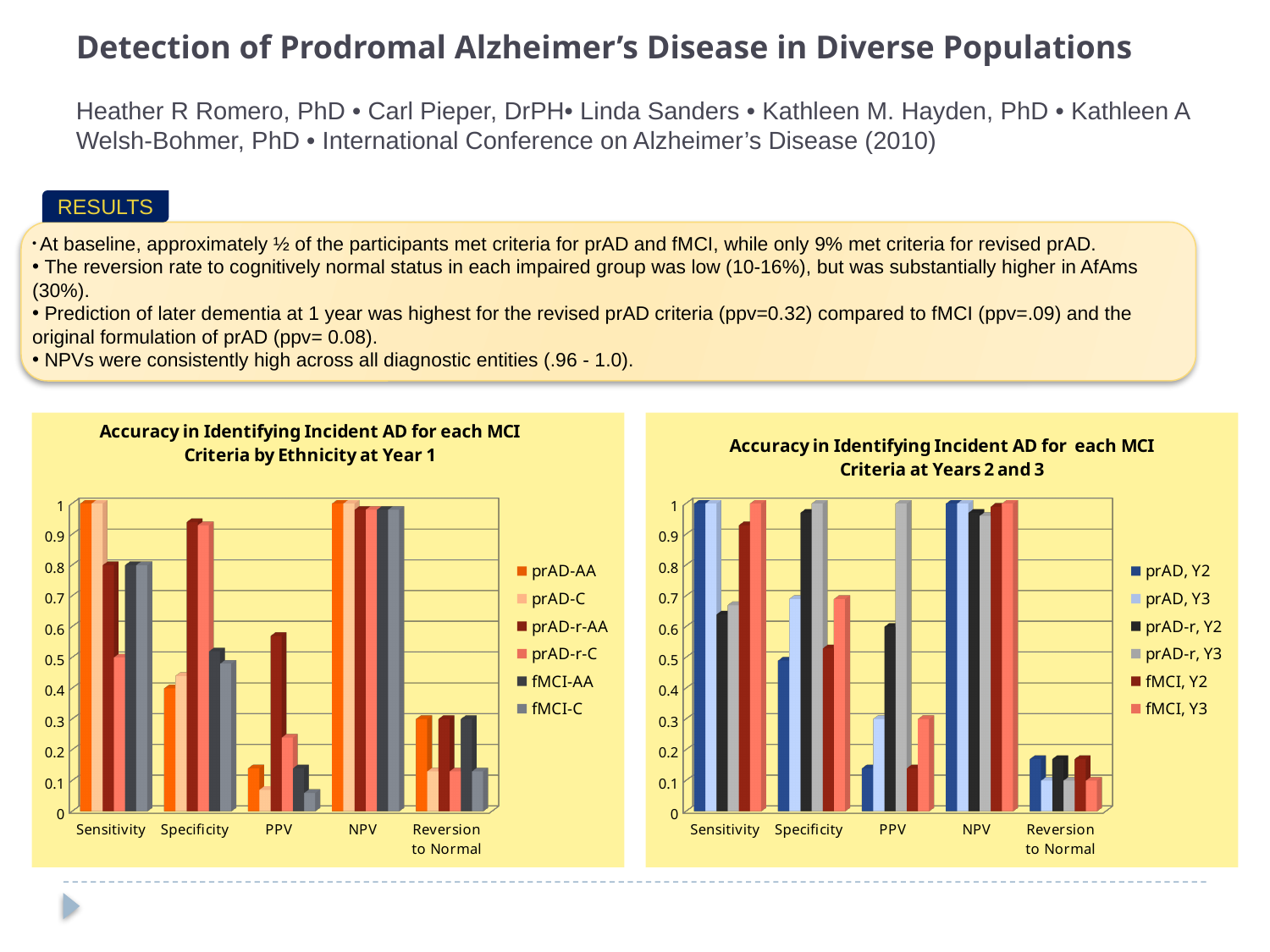
What kind of chart is the left chart, 'Accuracy in Identifying Incident AD for each MCI Criteria by Ethnicity at Year 1'? bar chart In the left chart (by Ethnicity at Year 1), is the Sensitivity value for prAD-AA greater or less than 0.9? greater In the right chart (at Years 2 and 3), is the PPV value for prAD, Y2 greater or less than 0.3? less In the right chart (at Years 2 and 3), which is larger for Specificity: prAD, Y2 or prAD-r, Y2? prAD-r, Y2 In the right chart (at Years 2 and 3), is the Sensitivity value for fMCI, Y2 greater or less than 0.8? greater In the left chart (by Ethnicity at Year 1), which series has the highest PPV value? prAD-r-AA What is the title of the right chart? Accuracy in Identifying Incident AD for each MCI Criteria at Years 2 and 3 How many series does the legend of the left chart (by Ethnicity at Year 1) list? 6 In the left chart (by Ethnicity at Year 1), which is larger for PPV: prAD-AA or prAD-r-AA? prAD-r-AA How many categories are shown on the x axis of the right chart (at Years 2 and 3)? 5 In the right chart (at Years 2 and 3), which series has the highest PPV value? prAD-r, Y3